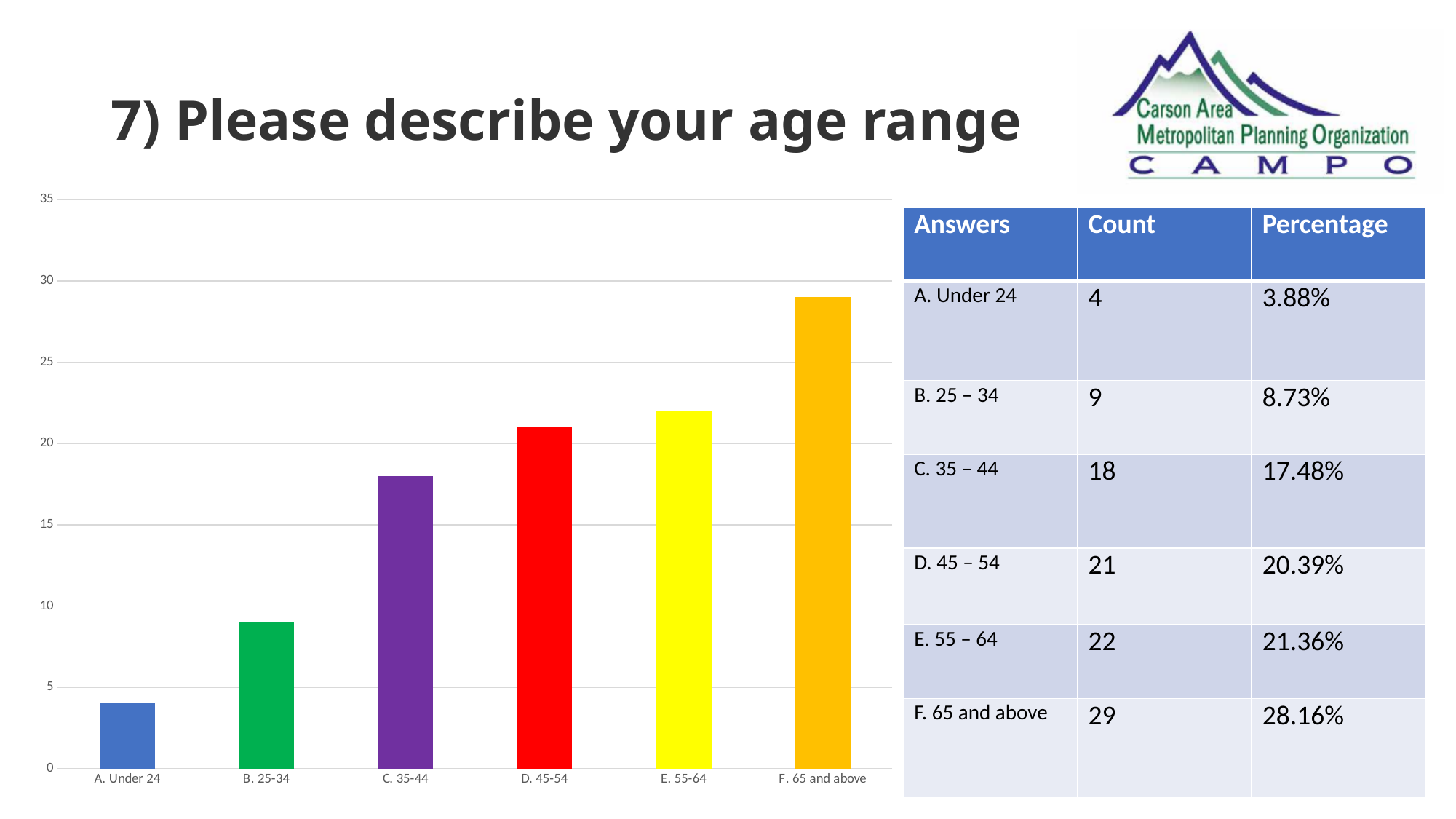
What is the difference between the counts for F. 65 and above and A. Under 24? 25 Which age range has the lowest bar? A. Under 24 What is the count for F. 65 and above? 29 Is the value for B. 25-34 greater or less than 10? less How many age-range categories does the chart show? 6 Which age range has the highest bar? F. 65 and above What is the count for A. Under 24? 4 Do the bar values rise or fall from left to right along the x axis? rise Which is larger, the value for C. 35-44 or the value for E. 55-64? E. 55-64 Is the value for D. 45-54 greater or less than 20? greater What is the count for C. 35-44? 18 What kind of chart is shown on the slide? bar chart